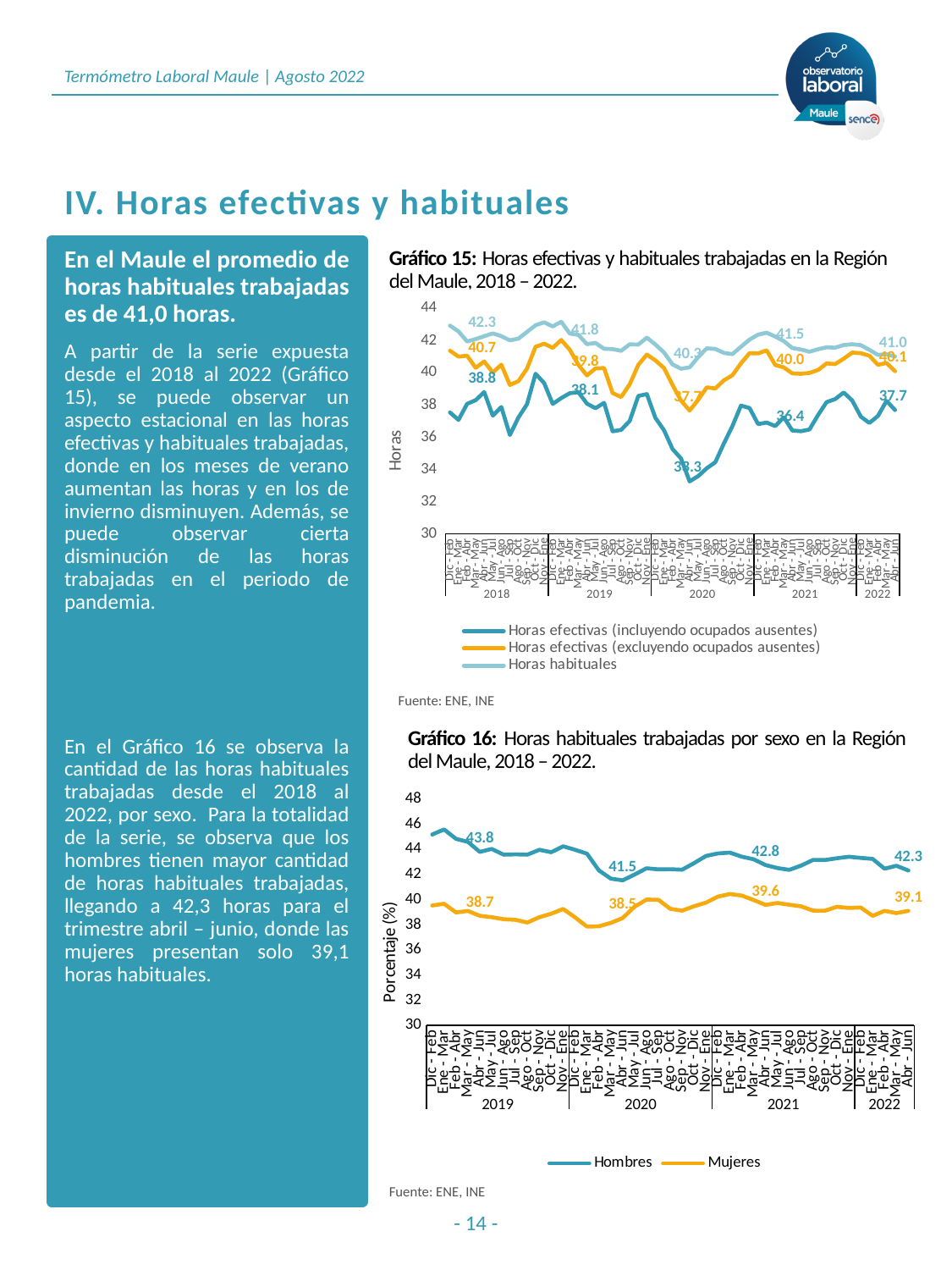
What kind of chart is Gráfico 16? Line chart In Gráfico 16, which series has higher values throughout the period, Hombres or Mujeres? Hombres In Gráfico 15, what is the last labelled value for Horas habituales in 2022? 41.0 In Gráfico 16, what is the last labelled value for Hombres in 2022? 42.3 In Gráfico 15, what is the difference between the 2018 labelled Horas habituales value (42.3) and the 2022 labelled value (41.0)? 1.3 In Gráfico 15, what is the lowest labelled value for Horas efectivas (incluyendo ocupados ausentes)? 33.3 In Gráfico 15, how many series does the legend list? 3 In Gráfico 15, what is the labelled value for Horas habituales at the start of the series in 2018? 42.3 In Gráfico 16, what is the difference between the last labelled Hombres value (42.3) and the last labelled Mujeres value (39.1)? 3.2 In Gráfico 16, what is the last labelled value for Mujeres in 2022? 39.1 What is the y-axis title of Gráfico 16? Porcentaje (%) In Gráfico 16, how many series does the legend list? 2